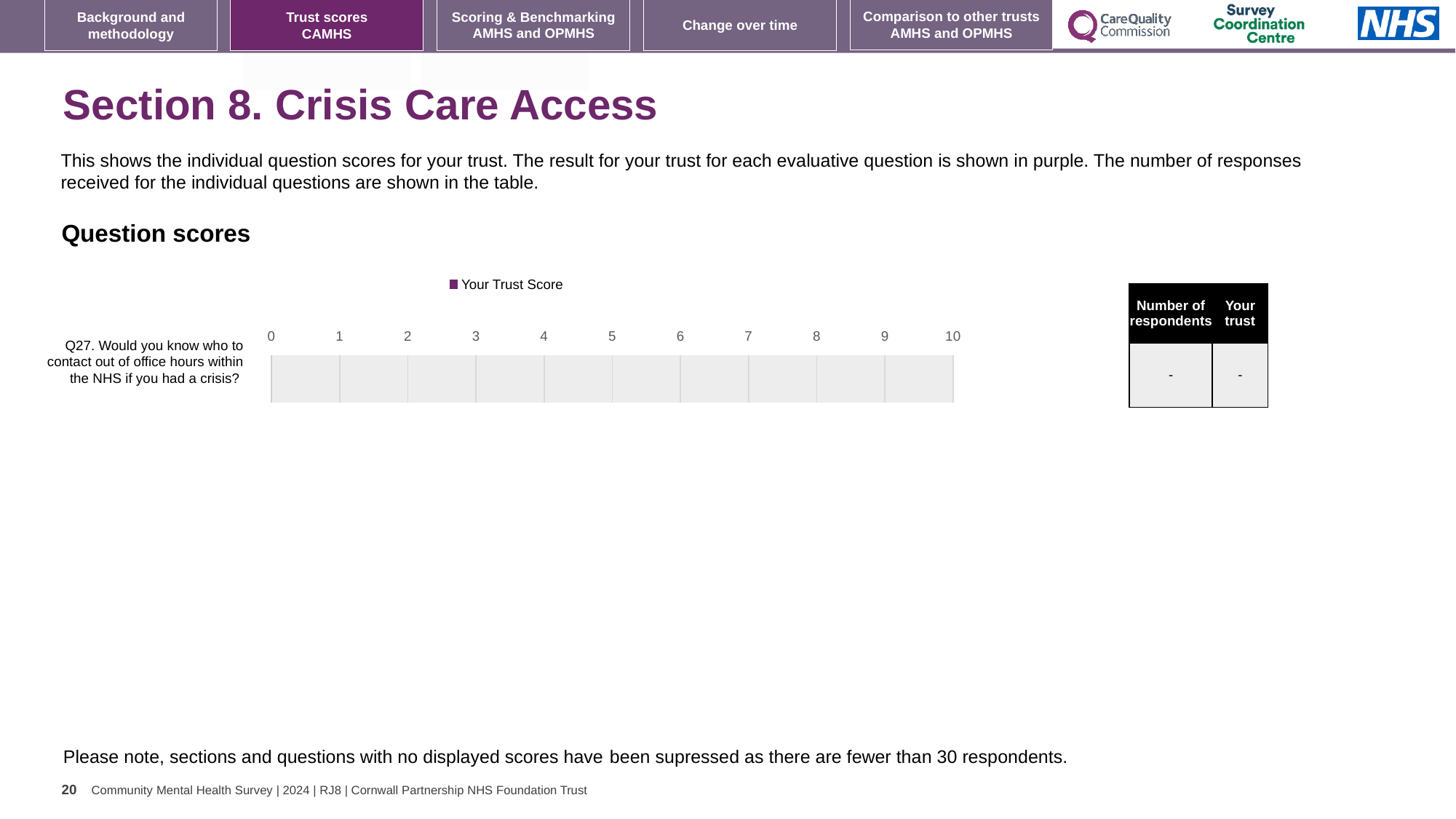
How many questions (categories) are plotted on the Question scores chart? 1 What is the name of the series shown in the legend of the Question scores chart? Your Trust Score Which question is listed as the category on the Question scores chart? Q27. Would you know who to contact out of office hours within the NHS if you had a crisis? What kind of chart is the Question scores chart? bar chart How many series does the legend of the Question scores chart list? 1 What is the highest value shown on the x axis of the Question scores chart? 10